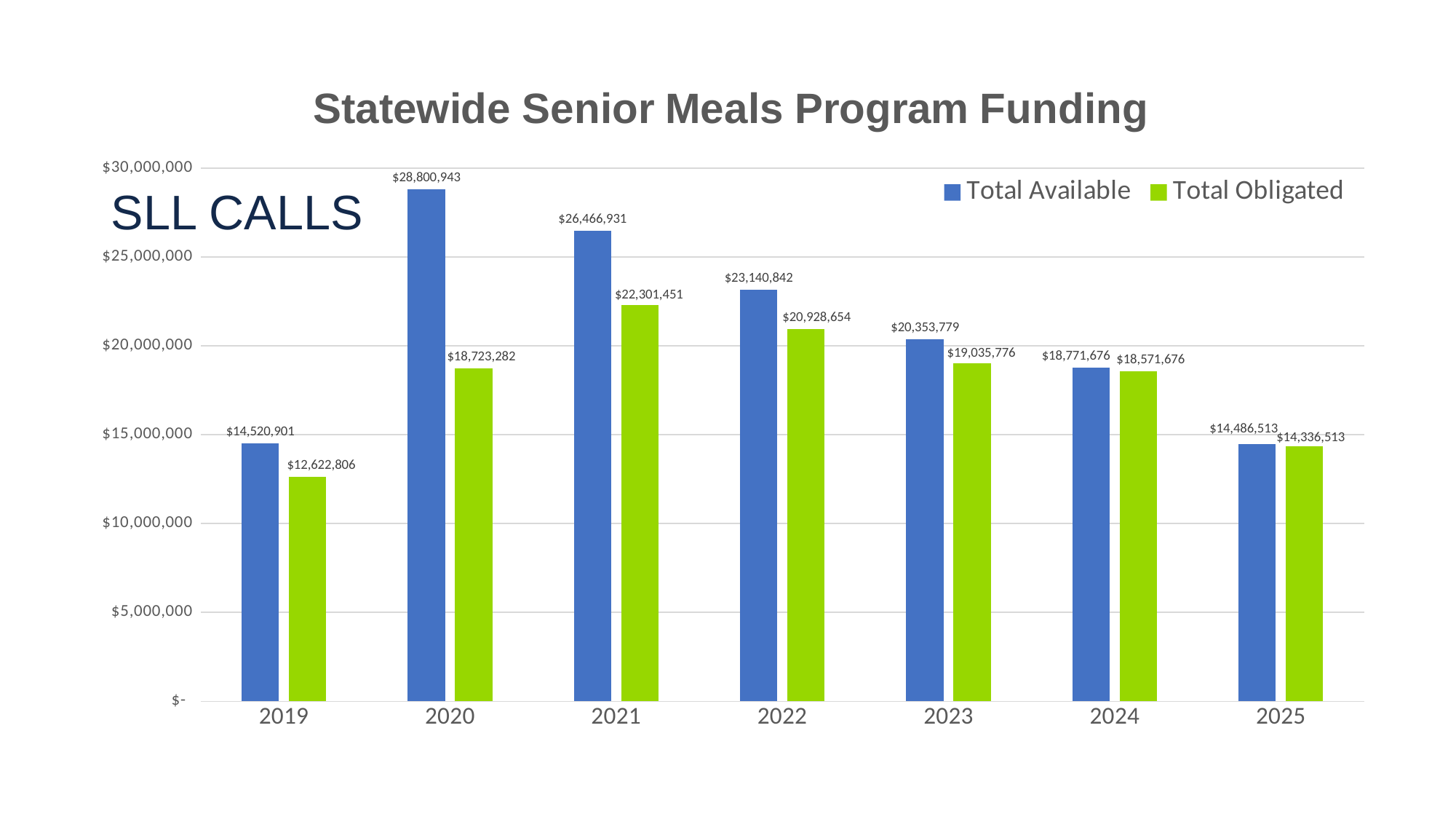
What is the Total Available value for 2020? $28,800,943 Which year has the highest Total Available value? 2020 What is the difference between Total Available and Total Obligated in 2024? $200,000 Which is larger in 2021, Total Available or Total Obligated? Total Available What is the difference between Total Available and Total Obligated in 2020? $10,077,661 How many years are shown on the x axis? 7 Which year has the lowest Total Obligated value? 2019 What is the Total Available value for 2023? $20,353,779 Does the Total Available value rise or fall from 2020 to 2025? Fall How many series does the legend list? 2 What is the Total Obligated value for 2022? $20,928,654 Which year has the highest Total Obligated value? 2021